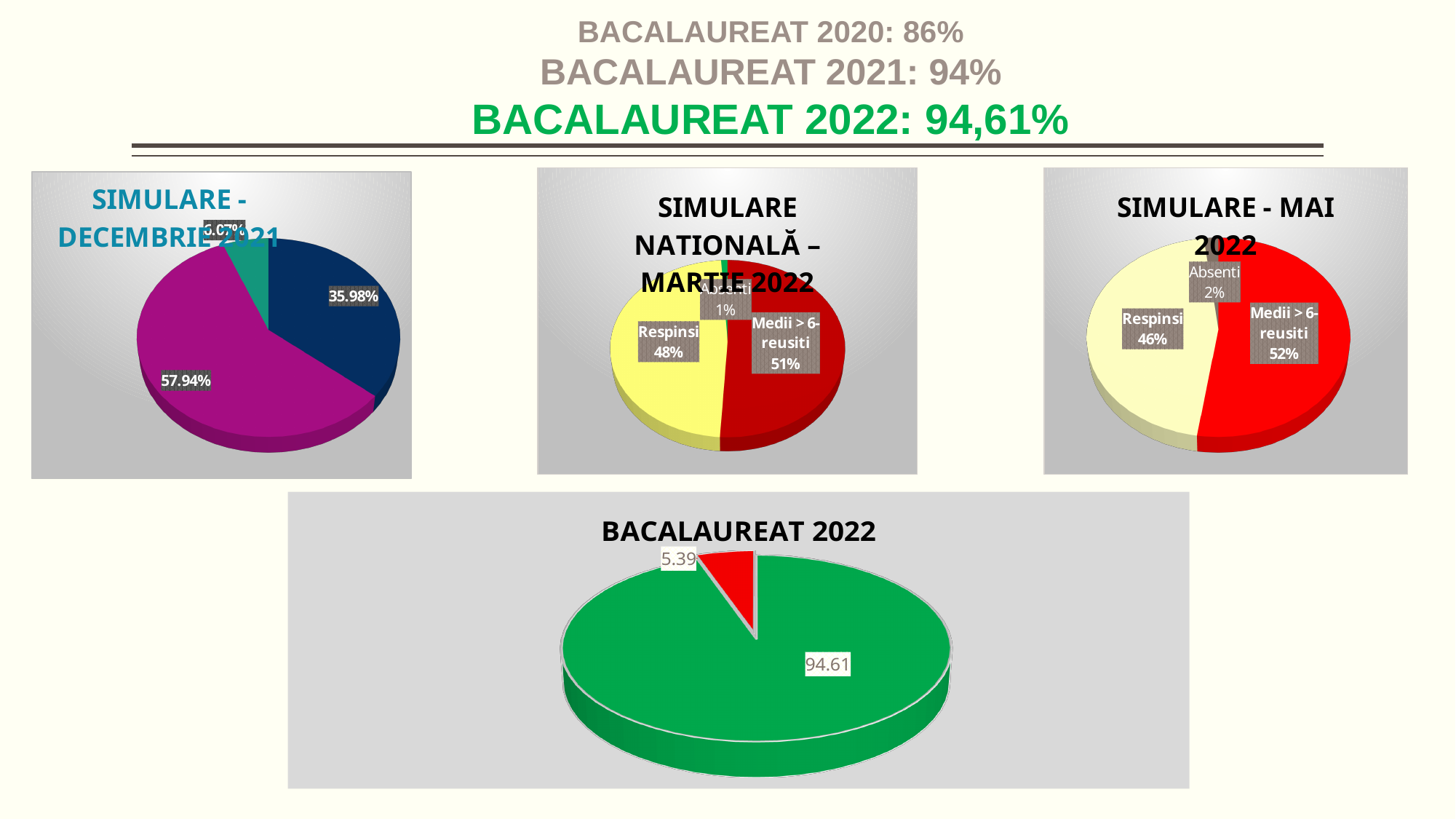
What type of chart is the SIMULARE - DECEMBRIE 2021 chart? Pie chart How many slices does the BACALAUREAT 2022 chart at the bottom have? 2 In the SIMULARE - MAI 2022 chart, which is larger, Respinsi or Medii > 6-reusiti? Medii > 6-reusiti In the SIMULARE NATIONALĂ – MARTIE 2022 chart, what is the value for Respinsi? 48% In the SIMULARE NATIONALĂ – MARTIE 2022 chart, which category has the largest share? Medii > 6-reusiti In the SIMULARE - MAI 2022 chart, what is the difference between Respinsi and Absenti in percentage points? 44 In the SIMULARE - DECEMBRIE 2021 chart, what is the value of the largest slice? 57.94% In the SIMULARE NATIONALĂ – MARTIE 2022 chart, by how many percentage points does Medii > 6-reusiti exceed Respinsi? 3 In the SIMULARE - MAI 2022 chart, what is the value for Medii > 6-reusiti? 52% In the BACALAUREAT 2022 chart at the bottom, what is the value of the green slice? 94.61 In the SIMULARE - MAI 2022 chart, which category has the smallest share? Absenti In the BACALAUREAT 2022 chart at the bottom, what is the difference between the two slice values? 89.22